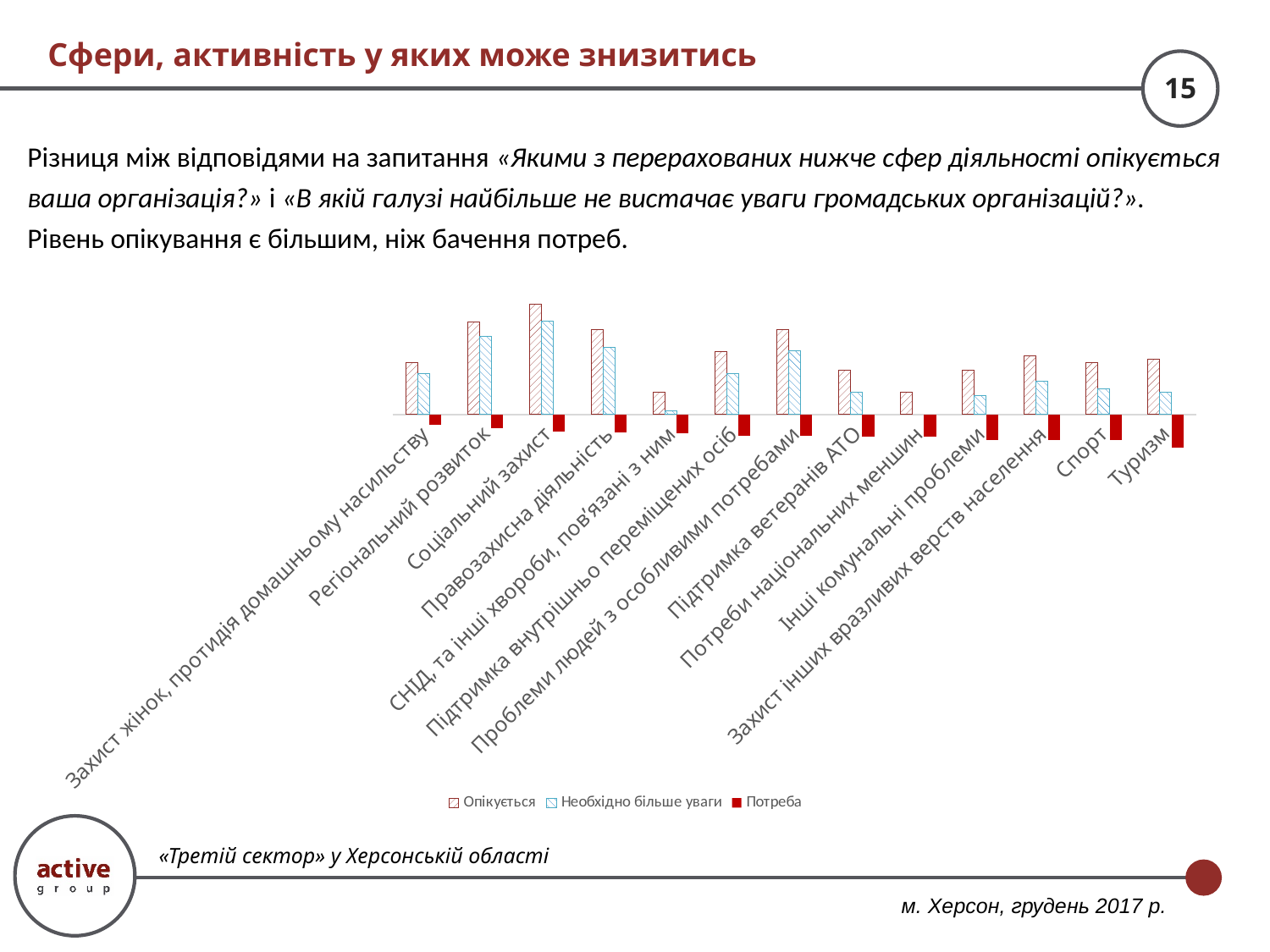
Which category has the highest value for the series "Опікується"? Соціальний захист Which series in the chart is drawn with solid red bars below the axis? Потреба For the series "Опікується", which is larger: "Регіональний розвиток" or "Спорт"? Регіональний розвиток For the series "Необхідно більше уваги", which is larger: "Проблеми людей з особливими потребами" or "Підтримка ветеранів АТО"? Проблеми людей з особливими потребами For the series "Опікується", which is larger: "Соціальний захист" or "Потреби національних меншин"? Соціальний захист What are the three series names listed in the chart legend? Опікується, Необхідно більше уваги, Потреба How many series does the chart legend list? 3 What kind of chart is shown on the slide? Bar chart Which category has the lowest (most negative) value for the series "Потреба"? Туризм Which category has the highest value for the series "Необхідно більше уваги"? Соціальний захист How many categories are plotted along the x axis of the chart? 13